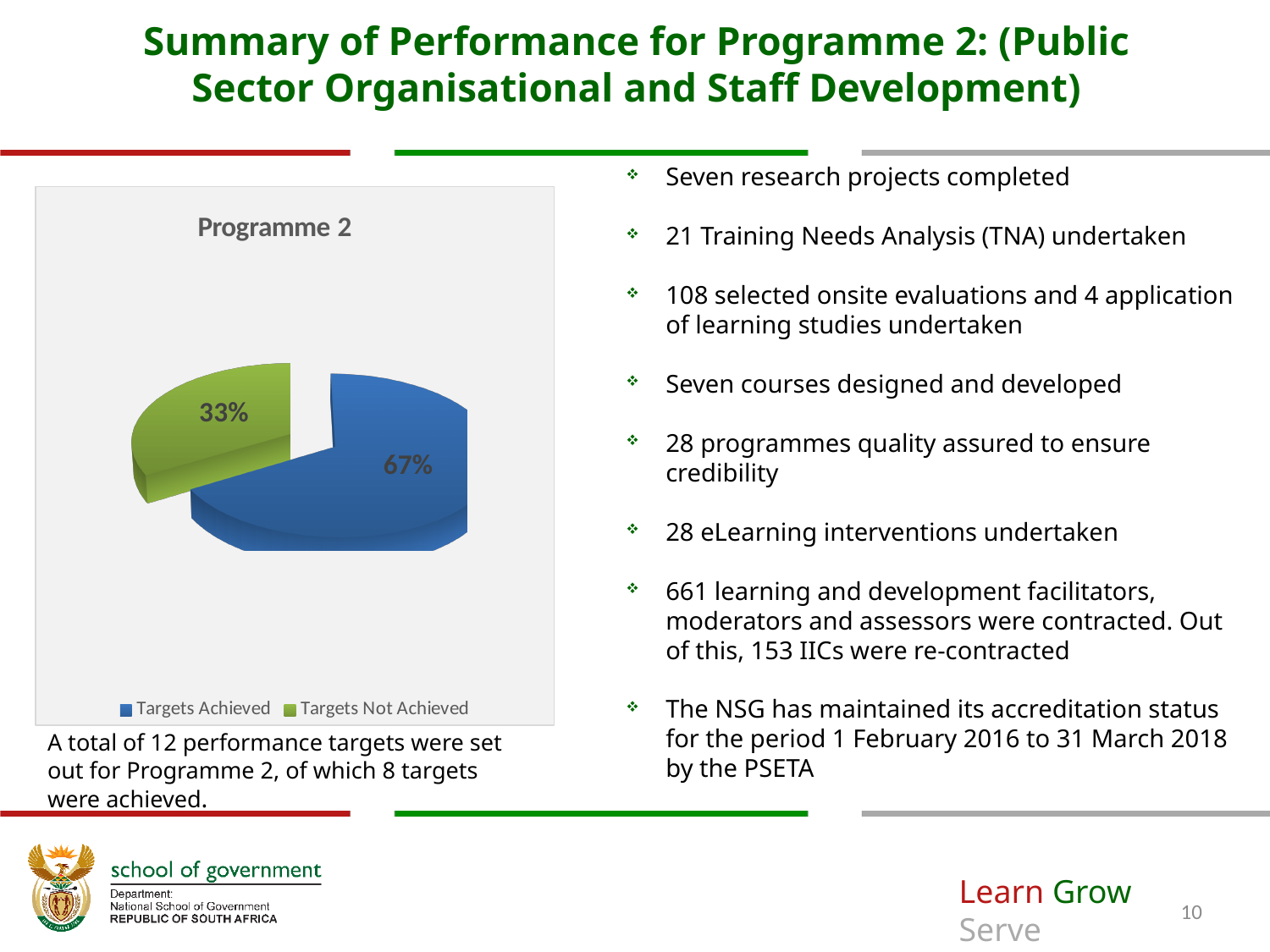
Which is larger, the Targets Achieved slice or the Targets Not Achieved slice? Targets Achieved Which slice of the pie is the largest? Targets Achieved Which slice of the pie is the smallest? Targets Not Achieved What kind of chart is shown on the slide? pie chart What share of the pie is labelled Targets Not Achieved? 33% How many slices does the pie chart have? 2 What colour is the Targets Not Achieved slice? green What is the difference in percentage points between the Targets Achieved and Targets Not Achieved slices? 34 What is the title of the chart? Programme 2 What share of the pie is labelled Targets Achieved? 67% How many entries does the legend list? 2